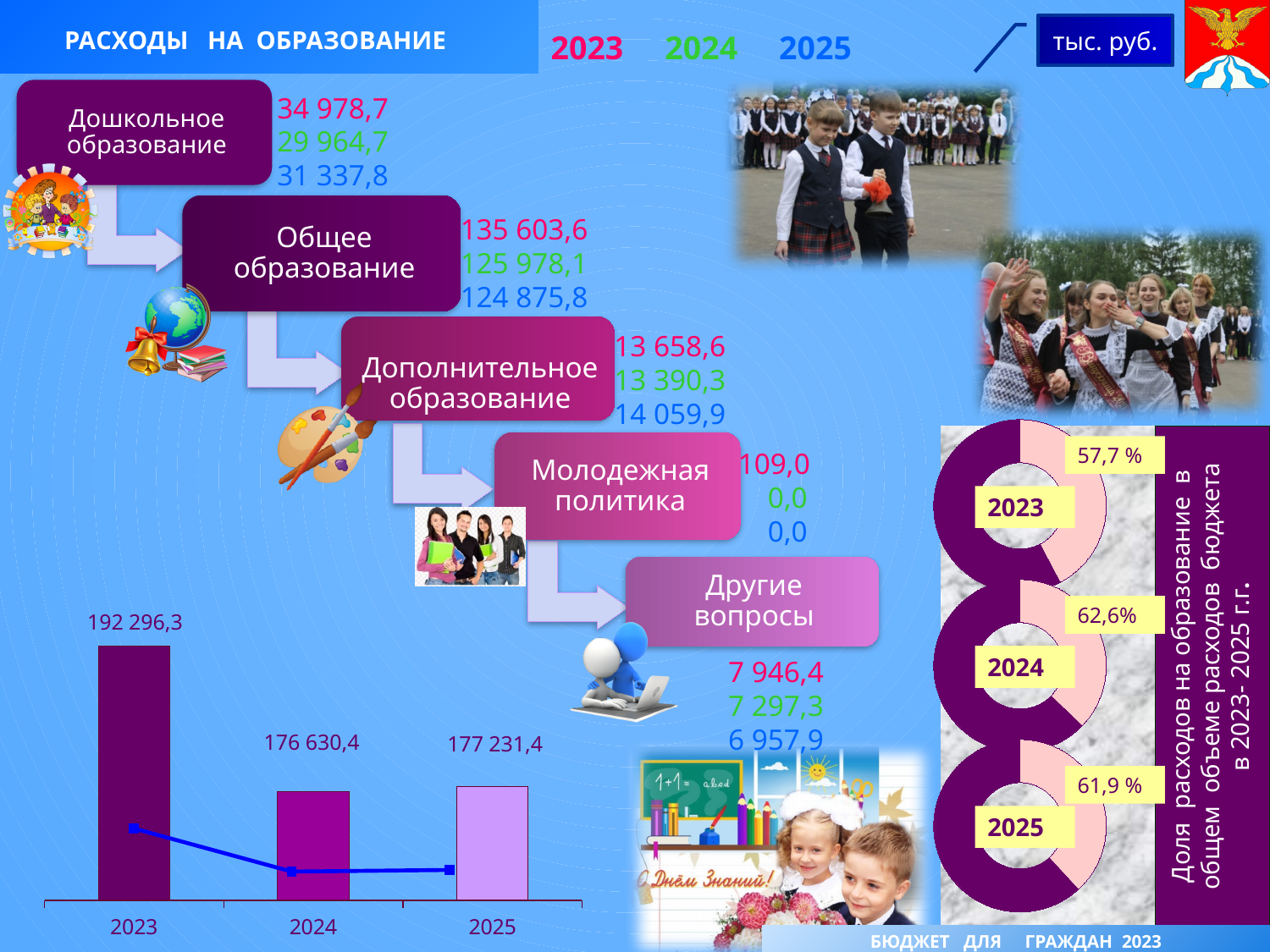
In the bar chart at the bottom left, which year has the lowest value? 2024 In the bar chart at the bottom left, what is the value for 2024? 176 630,4 In the bar chart at the bottom left, what is the difference between the values for 2025 and 2024? 601,0 What kind of chart is shown at the bottom left of the slide? bar chart In the bar chart at the bottom left, which is larger, the value for 2023 or the value for 2025? 2023 How many bars are shown in the bar chart at the bottom left? 3 In the bar chart at the bottom left, which year has the highest value? 2023 In the bar chart at the bottom left, what is the value for 2025? 177 231,4 In the bar chart at the bottom left, does the value fall or rise from 2023 to 2024? fall In the bar chart at the bottom left, what is the value for 2023? 192 296,3 In the share graphic on the right of the slide, which year has the highest share of education expenses in the budget? 2024 In the bar chart at the bottom left, what is the difference between the values for 2023 and 2024? 15 665,9